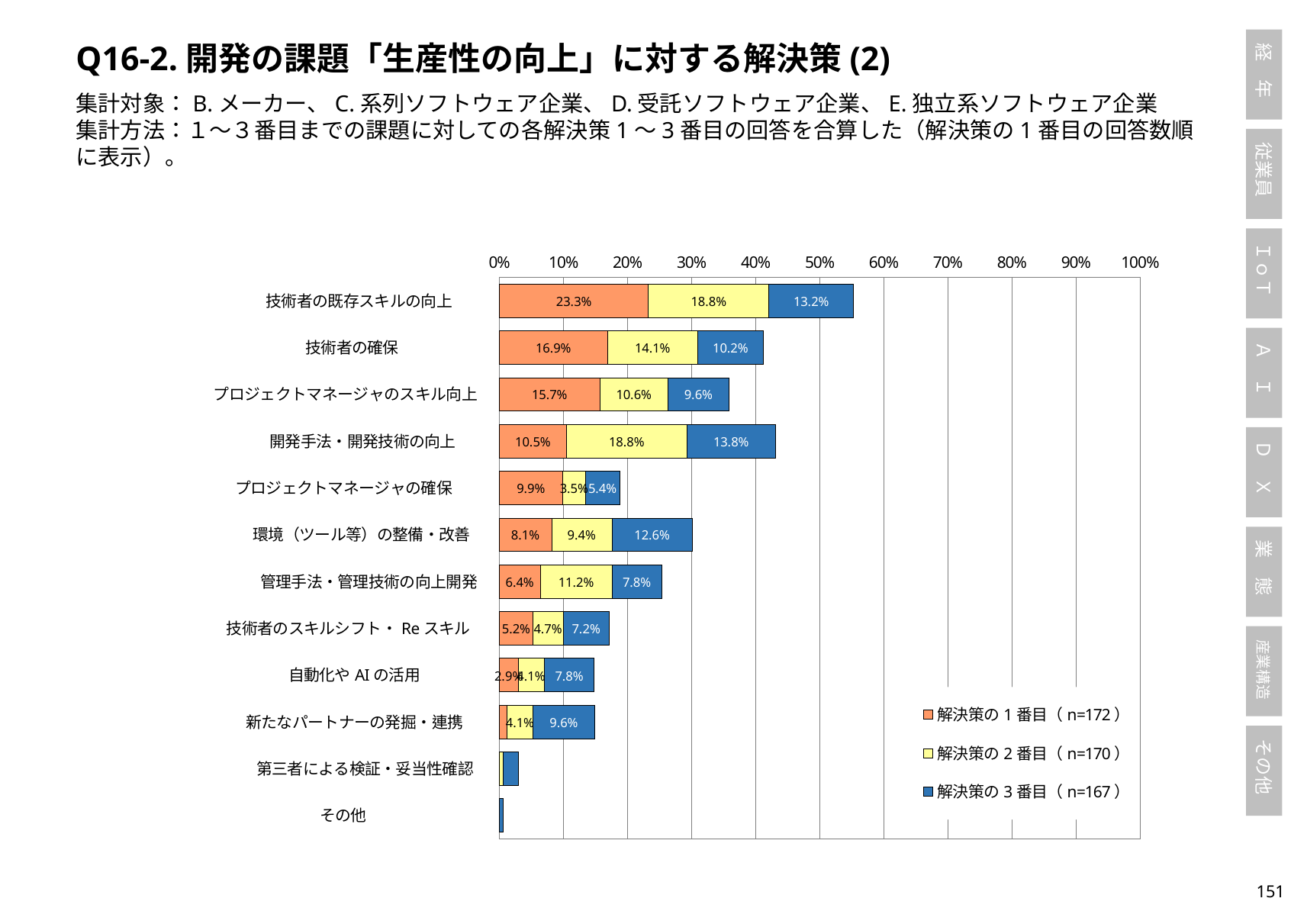
What is the value of 解決策の1番目 for 技術者の既存スキルの向上? 23.3% How many categories are plotted on the chart? 12 How many series does the legend list? 3 What is the total of the stacked bar for 技術者の確保? 41.2% Is the total stacked bar for 第三者による検証・妥当性確認 greater or less than 10%? less What is the value of 解決策の2番目 for 管理手法・管理技術の向上開発? 11.2% What is the sample size (n) shown in the legend for 解決策の2番目? n=170 What is the value of 解決策の3番目 for 開発手法・開発技術の向上? 13.8% Which category has the highest value for 解決策の1番目? 技術者の既存スキルの向上 What kind of chart is shown on the slide? stacked bar chart Which is larger: the 解決策の3番目 value for 環境（ツール等）の整備・改善 or for 技術者の確保? 環境（ツール等）の整備・改善 What is the difference between the 解決策の1番目 values for 技術者の確保 and プロジェクトマネージャのスキル向上? 1.2%